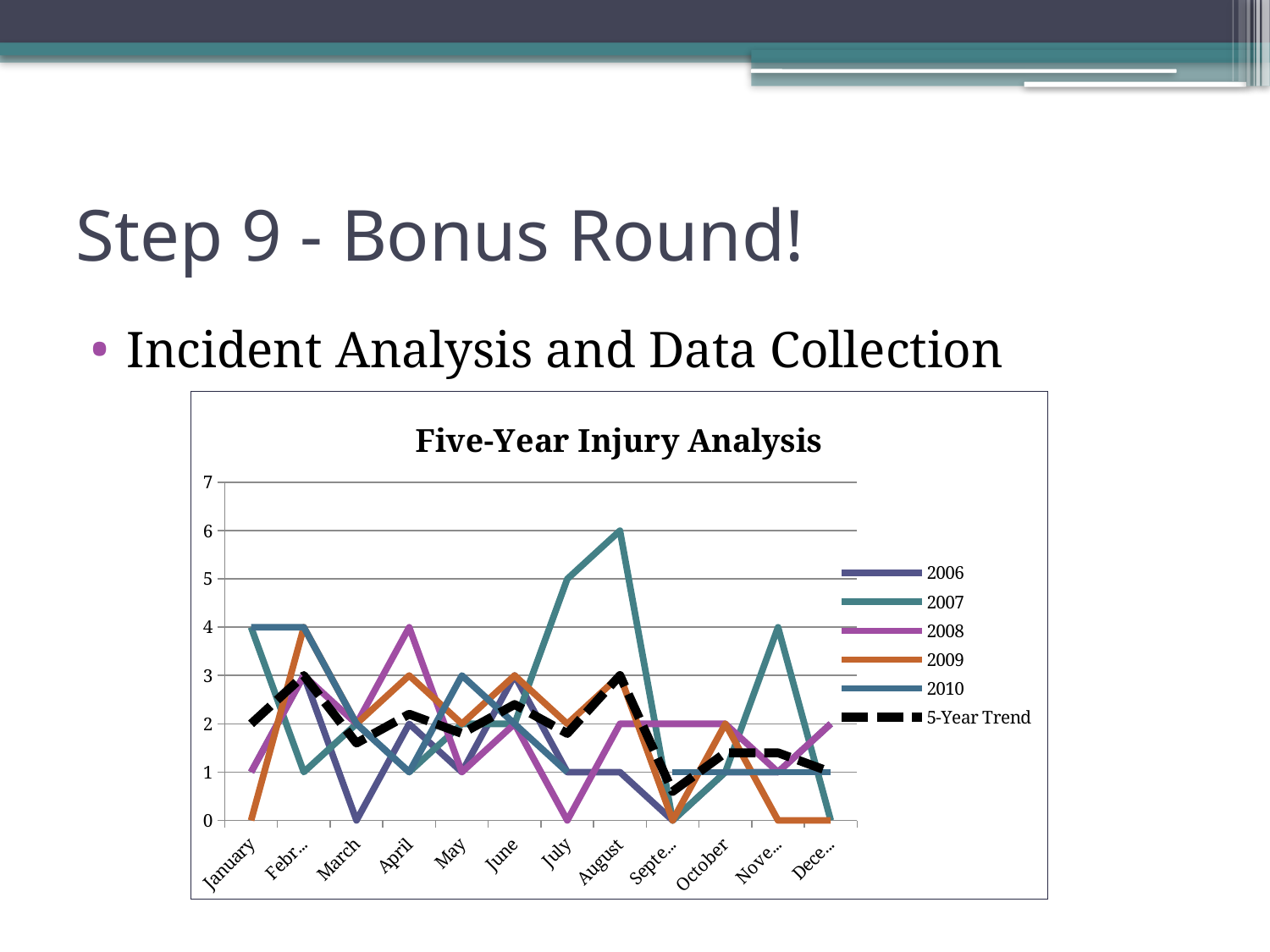
Is the value for 2007 in August greater or less than 5? greater What is the title of the chart? Five-Year Injury Analysis Which is larger in August, the value for 2007 or the value for 2008? 2007 What is the difference between the 2007 values for August and July? 1 What is the value for 2007 in July? 5 How many months are shown along the x axis? 12 What is the value for 2007 in August? 6 What is the value for 2008 in April? 4 What kind of chart is shown on the slide? line chart In which month does the 2007 series reach its highest value? August How many series does the legend list? 6 What is the value for 2008 in July? 0